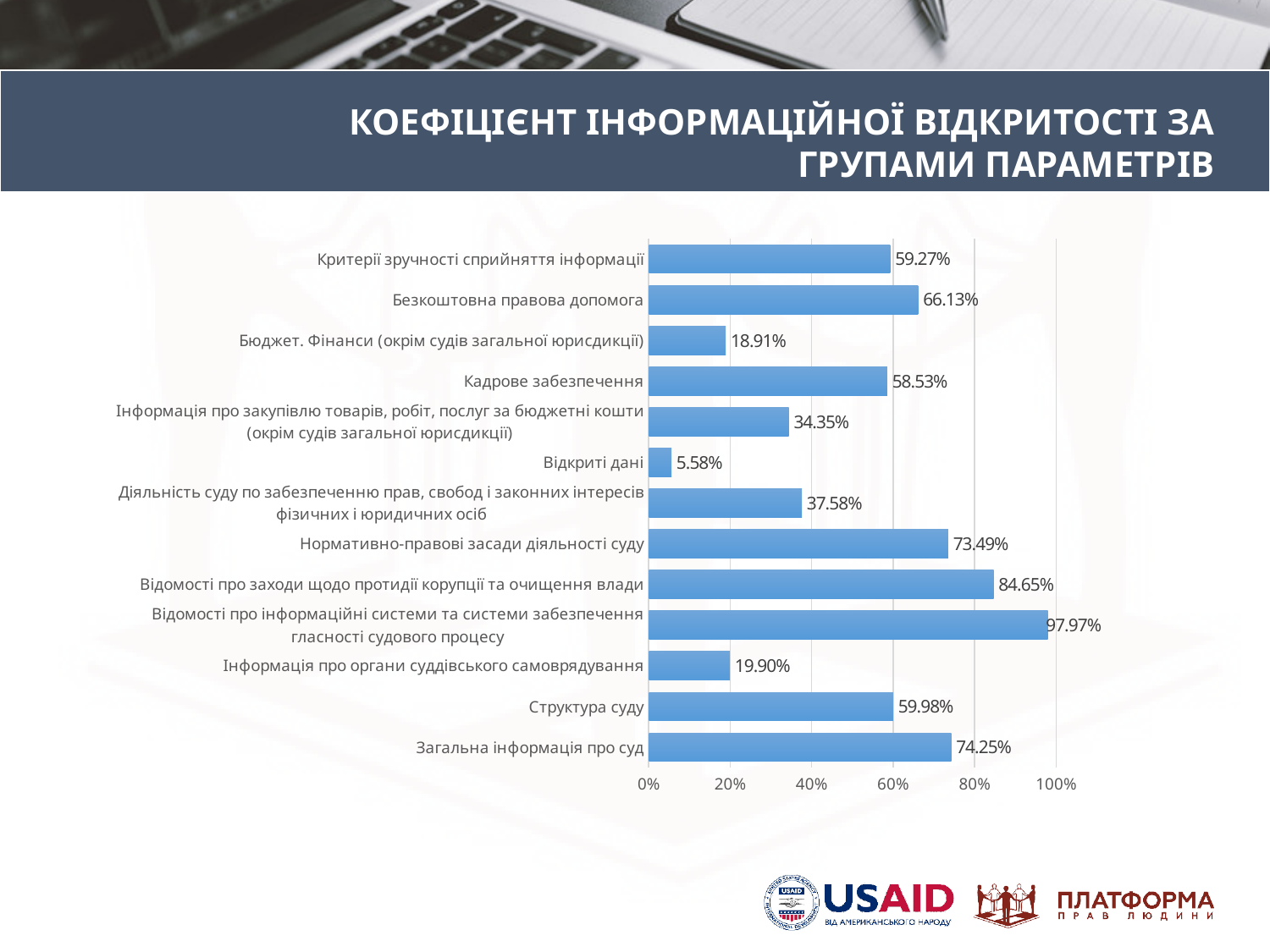
What is the value for Загальна інформація про суд? 74.25% What is the difference between the values for Безкоштовна правова допомога and Критерії зручності сприйняття інформації? 6.86% What is the value for Відкриті дані? 5.58% Which category has the lowest value? Відкриті дані Is the value for Діяльність суду по забезпеченню прав, свобод і законних інтересів фізичних і юридичних осіб greater or less than 40%? less Which category has the highest value? Відомості про інформаційні системи та системи забезпечення гласності судового процесу What is the value for Кадрове забезпечення? 58.53% What kind of chart is shown on the slide? bar chart What is the value for Інформація про органи суддівського самоврядування? 19.90% Which is larger: the value for Нормативно-правові засади діяльності суду or the value for Безкоштовна правова допомога? Нормативно-правові засади діяльності суду How many categories are shown in the chart? 13 What is the difference between the values for Відомості про інформаційні системи та системи забезпечення гласності судового процесу and Відомості про заходи щодо протидії корупції та очищення влади? 13.32%